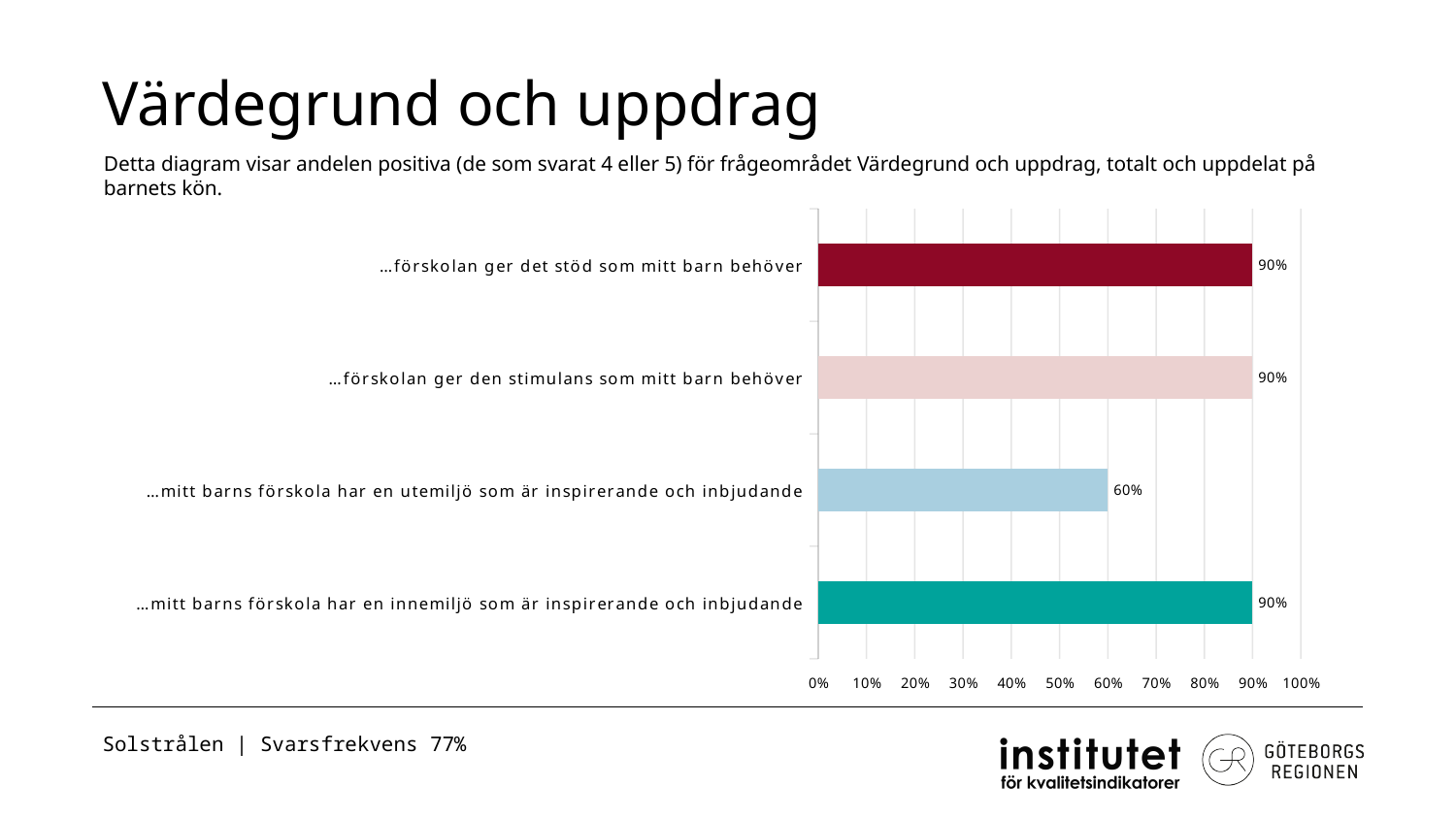
How many categories are shown in the chart? 4 Is the value for "…förskolan ger den stimulans som mitt barn behöver" greater or less than 80%? greater Which is larger: the value for "…mitt barns förskola har en innemiljö som är inspirerande och inbjudande" or the value for "…mitt barns förskola har en utemiljö som är inspirerande och inbjudande"? …mitt barns förskola har en innemiljö som är inspirerande och inbjudande What is the value for "…förskolan ger den stimulans som mitt barn behöver"? 90% What is the value for "…mitt barns förskola har en utemiljö som är inspirerande och inbjudande"? 60% Is the value for "…mitt barns förskola har en utemiljö som är inspirerande och inbjudande" greater or less than 70%? less What kind of chart is shown on the slide? bar chart What is the difference between the value for "…förskolan ger det stöd som mitt barn behöver" and the value for "…mitt barns förskola har en utemiljö som är inspirerande och inbjudande"? 30% What is the value for "…förskolan ger det stöd som mitt barn behöver"? 90% Which category has the lowest value? …mitt barns förskola har en utemiljö som är inspirerande och inbjudande What is the value for "…mitt barns förskola har en innemiljö som är inspirerande och inbjudande"? 90% What is the title of the slide containing the chart? Värdegrund och uppdrag